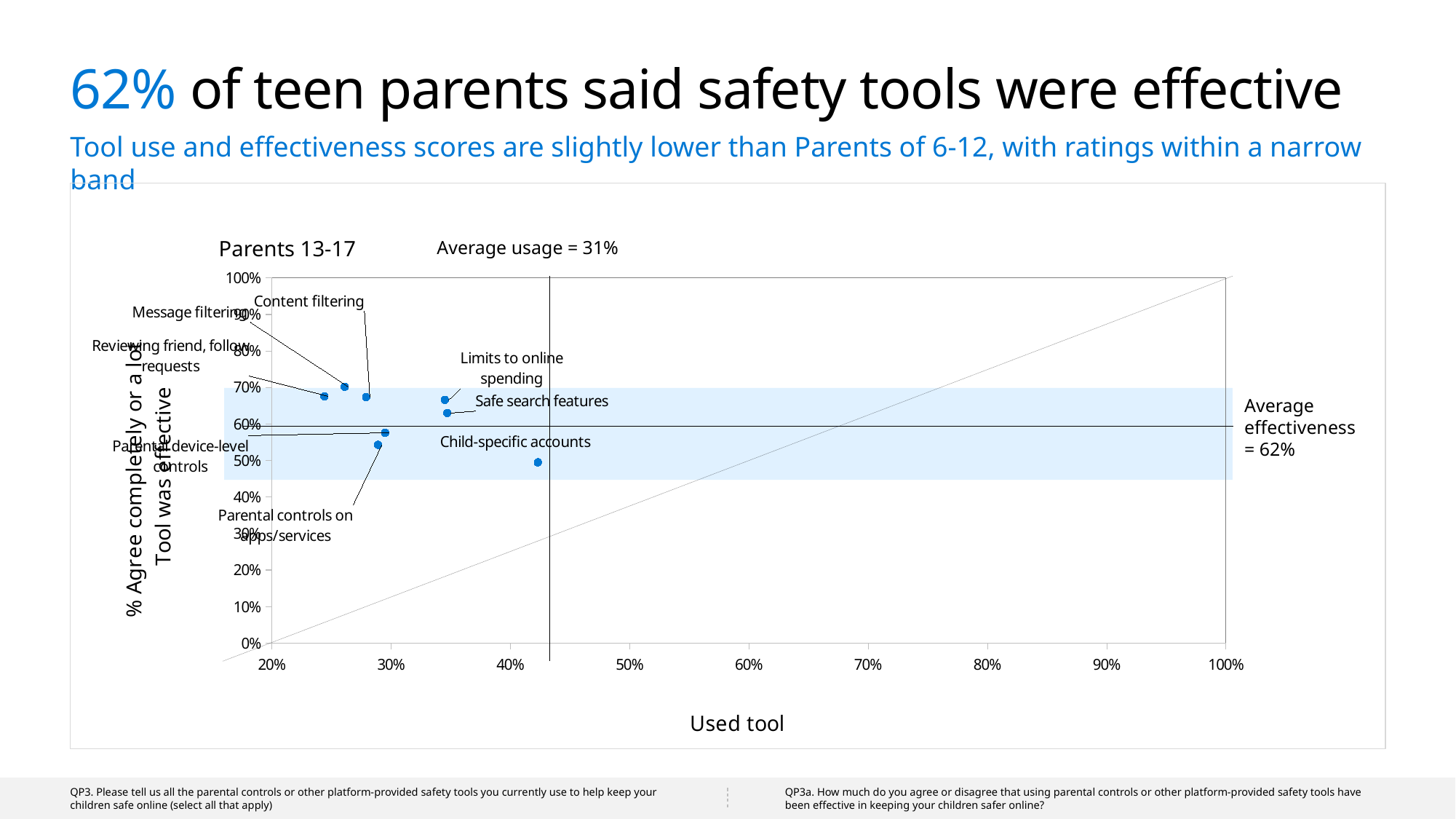
Is the effectiveness rating for Child-specific accounts greater or less than 60%? less Is the effectiveness rating for Message filtering greater or less than 60%? greater How many safety tools are plotted as points on the chart? 8 What is the title of the chart? Parents 13-17 Which tool has the lowest effectiveness rating? Child-specific accounts What is the average usage value annotated on the chart? 31% What is the average effectiveness value annotated on the chart? 62% Which has a higher effectiveness rating, Safe search features or Parental controls on apps/services? Safe search features Is the 'Used tool' value for Child-specific accounts greater or less than 40%? greater What kind of chart is shown on the slide? scatter chart What is the label of the horizontal axis? Used tool Which tool has the highest 'Used tool' percentage? Child-specific accounts